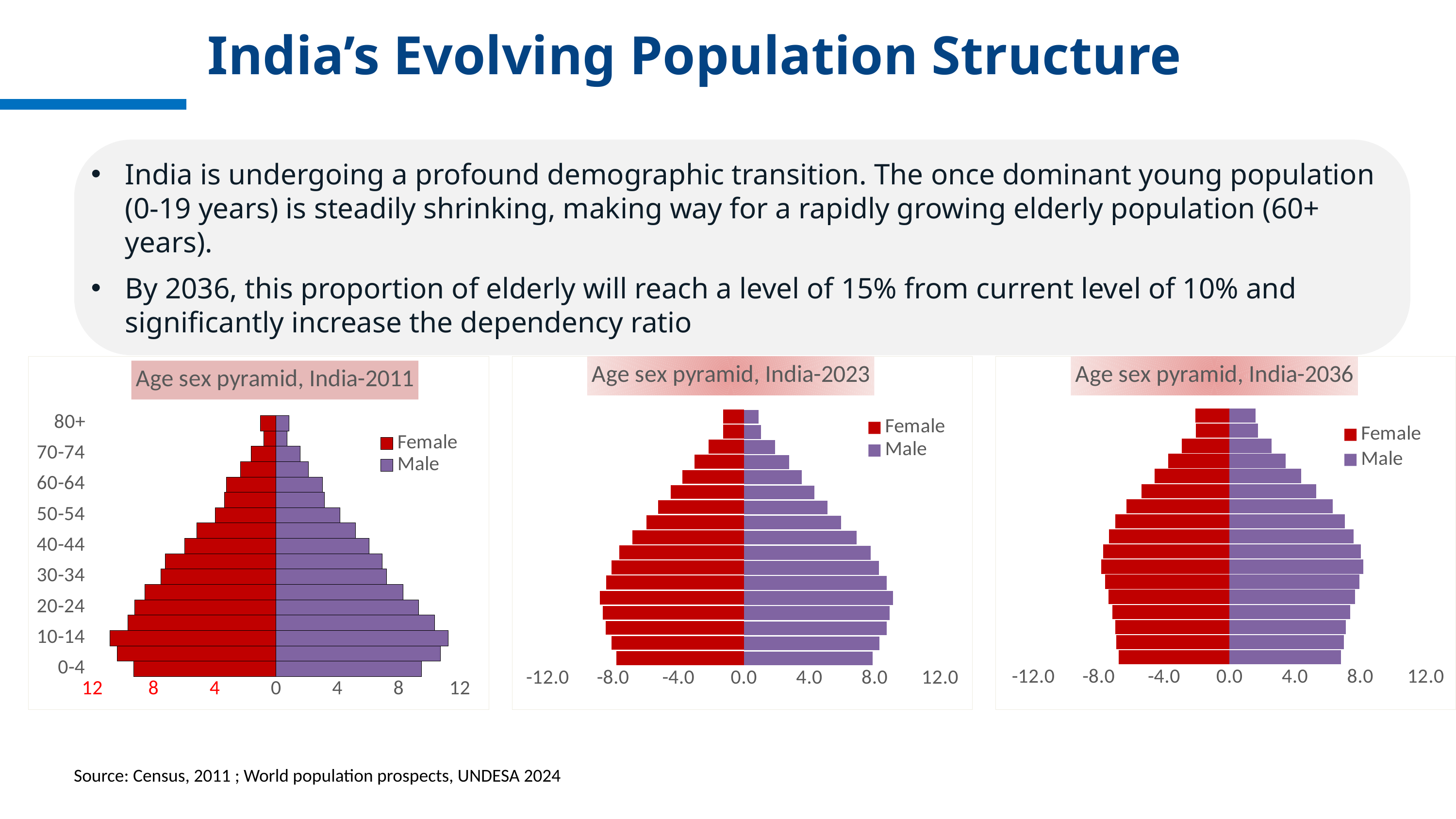
In the 'Age sex pyramid, India-2011' chart, is the Female value for 0-4 greater or less than 4? greater In the 'Age sex pyramid, India-2011' chart, which is larger: the Male bar for 10-14 or the Male bar for 60-64? 10-14 How many age-group labels are shown on the vertical axis of the 'Age sex pyramid, India-2011' chart? 9 What is the title of the middle chart on the slide? Age sex pyramid, India-2023 In the 'Age sex pyramid, India-2011' chart, do the bars get longer or shorter as age increases from 10-14 to 80+? shorter How many series does the legend of the 'Age sex pyramid, India-2023' chart list? 2 In the 'Age sex pyramid, India-2011' chart, which age group has the longest Male bar? 10-14 How many charts are shown on the slide? 3 What are the two legend entries in the 'Age sex pyramid, India-2036' chart? Female and Male What kind of chart is the 'Age sex pyramid, India-2011' chart? bar chart In the 'Age sex pyramid, India-2011' chart, is the Female value for 80+ greater or less than 4? less In the 'Age sex pyramid, India-2011' chart, is the Male value for 10-14 greater or less than 8? greater